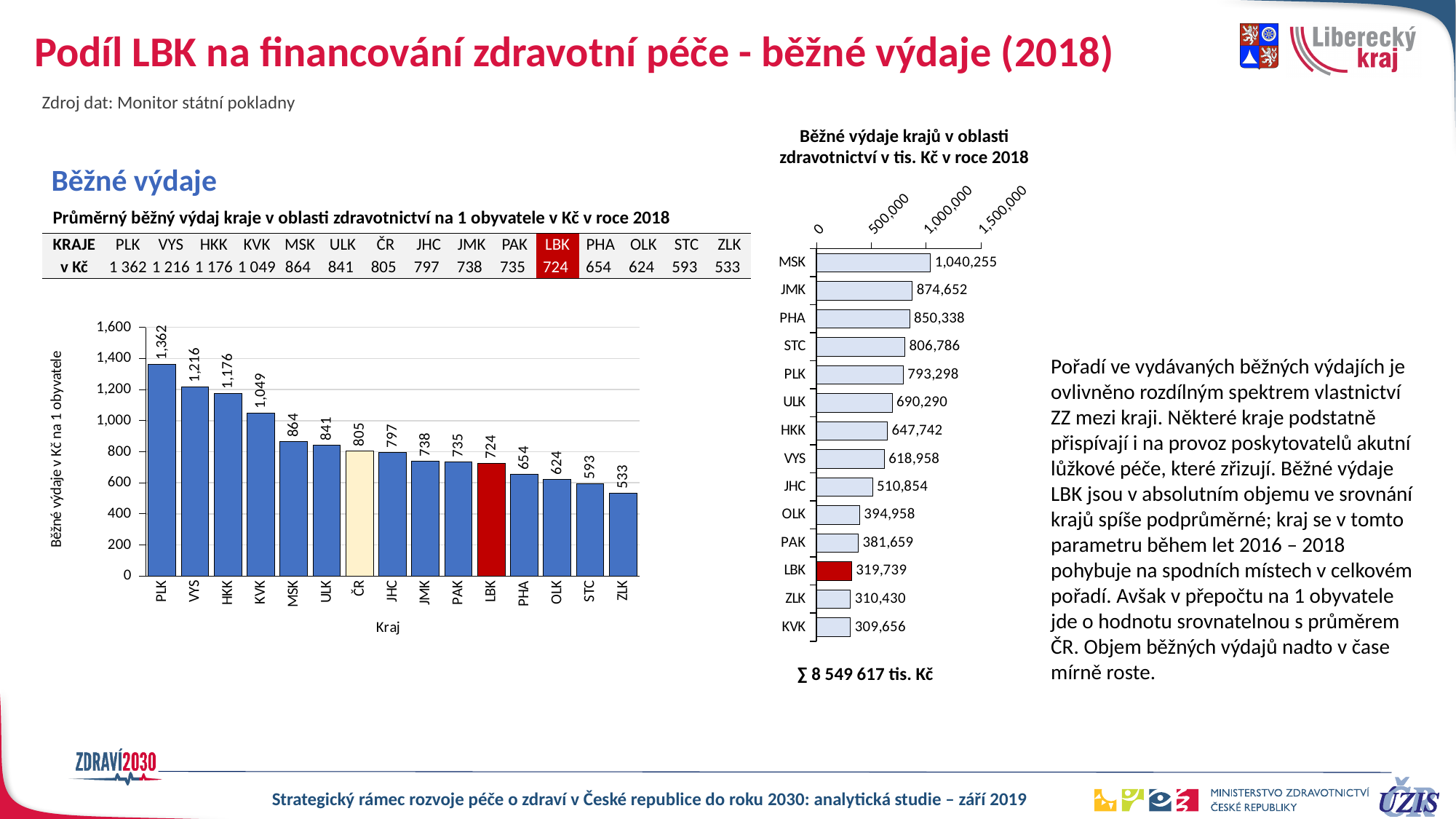
In the right chart (Běžné výdaje krajů v oblasti zdravotnictví v tis. Kč v roce 2018), which region has the lowest value? KVK What kind of chart is the right chart (Běžné výdaje krajů v oblasti zdravotnictví v tis. Kč v roce 2018)? bar chart In the left chart (Běžné výdaje v Kč na 1 obyvatele), do the values rise or fall from left to right along the x axis? fall In the left chart (Běžné výdaje v Kč na 1 obyvatele), how many bars are plotted? 15 In the right chart (Běžné výdaje krajů v oblasti zdravotnictví v tis. Kč v roce 2018), what is the value for LBK? 319,739 In the left chart (Běžné výdaje v Kč na 1 obyvatele), which region has the lowest value? ZLK In the left chart (Běžné výdaje v Kč na 1 obyvatele), which region has the highest value? PLK In the right chart (Běžné výdaje krajů v oblasti zdravotnictví v tis. Kč v roce 2018), which region has the highest value? MSK In the left chart (Běžné výdaje v Kč na 1 obyvatele), what is the value for LBK? 724 In the left chart (Běžné výdaje v Kč na 1 obyvatele), which is larger, the value for MSK or the value for ULK? MSK In the right chart (Běžné výdaje krajů v oblasti zdravotnictví v tis. Kč v roce 2018), how many regions are plotted? 14 In the left chart (Běžné výdaje v Kč na 1 obyvatele), what is the difference between PLK and ZLK? 829